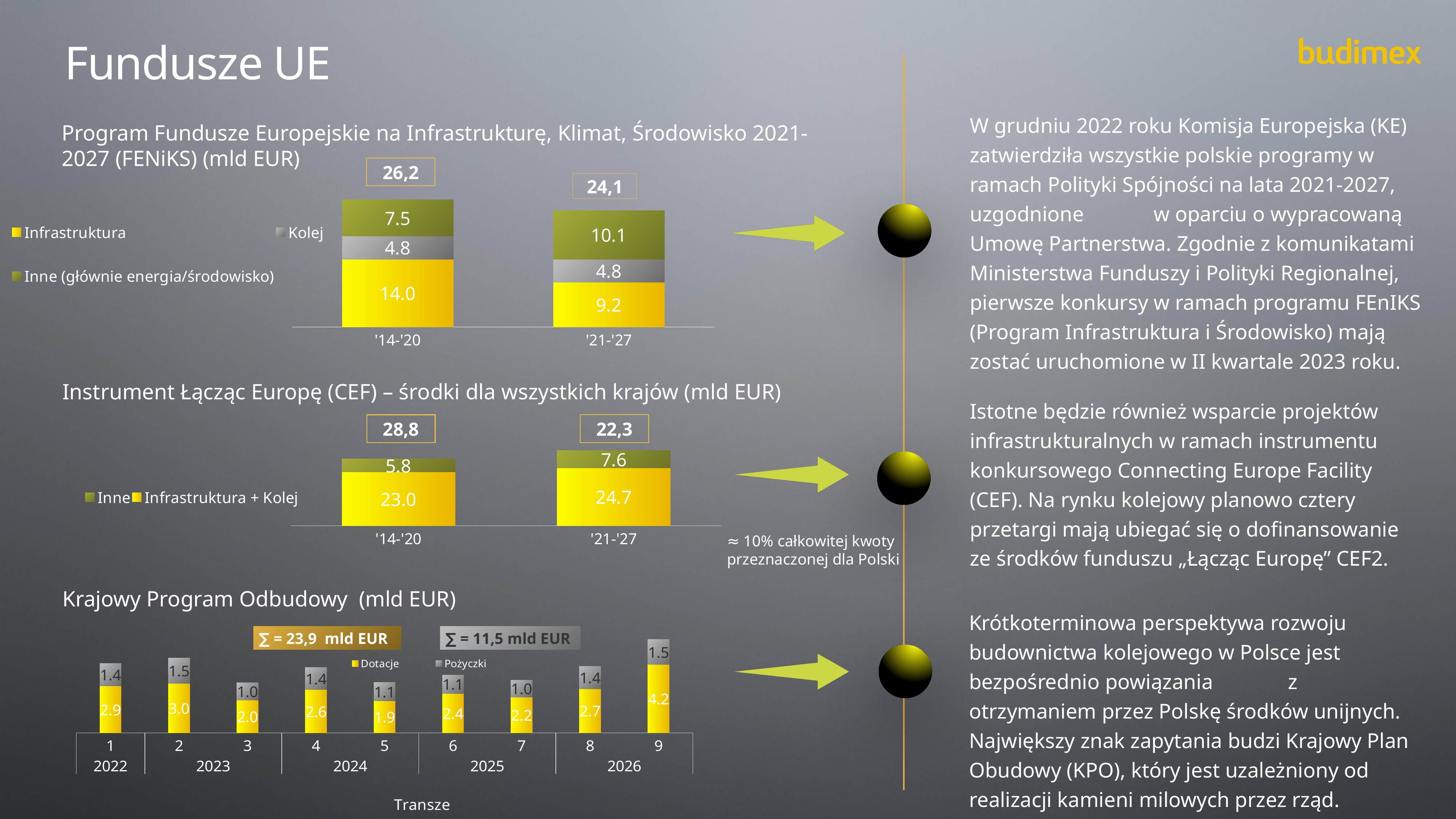
In the CEF chart, what is the Infrastruktura + Kolej value for '21-'27? 24.7 In the FENiKS chart, what is the total shown above the '21-'27 bar? 24,1 In the FENiKS chart, how many series does the legend list? 3 In the FENiKS chart, what is the Infrastruktura value for '14-'20? 14.0 In the Krajowy Program Odbudowy chart, how many tranches are shown on the x axis? 9 In the Krajowy Program Odbudowy chart, what is the Pożyczki value for tranche 3? 1.0 What type of chart is the Krajowy Program Odbudowy chart? Stacked bar chart In the CEF chart, which period has the larger Inne value, '14-'20 or '21-'27? '21-'27 In the CEF chart, what total is shown above the '14-'20 bar? 28,8 In the FENiKS chart, what is the Inne (głównie energia/środowisko) value for '21-'27? 10.1 In the FENiKS chart, what is the difference between the Infrastruktura values for '14-'20 and '21-'27? 4.8 In the Krajowy Program Odbudowy chart, which tranche has the highest Dotacje value? 9